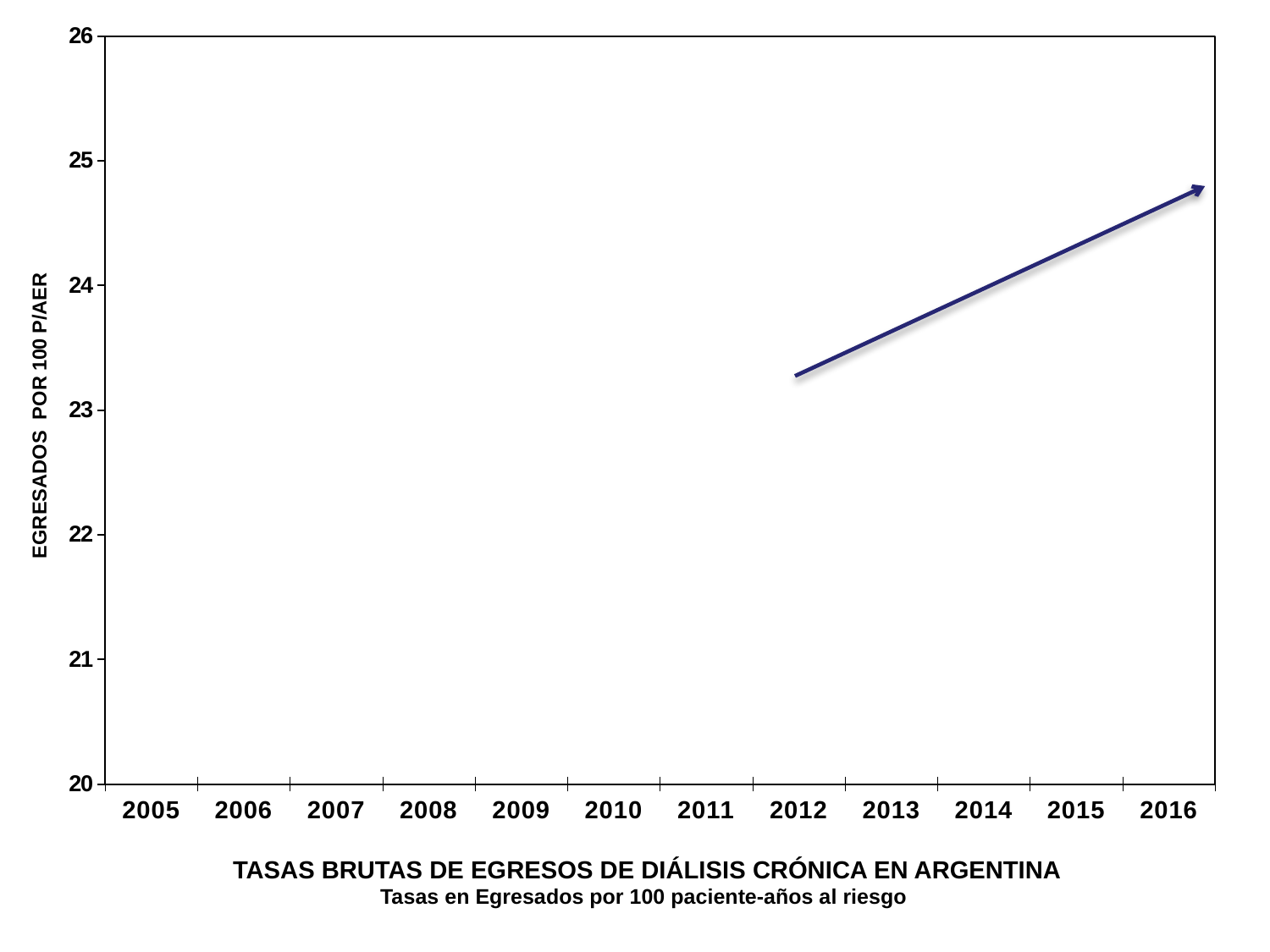
Does the arrow drawn on the chart rise or fall from 2012 to 2016? rise What is the last year shown on the x axis of the chart? 2016 What is the title of the chart? TASAS BRUTAS DE EGRESOS DE DIÁLISIS CRÓNICA EN ARGENTINA What is the label on the y axis of the chart? EGRESADOS POR 100 P/AER What is the first year shown on the x axis of the chart? 2005 How many years are labelled along the x axis of the chart? 12